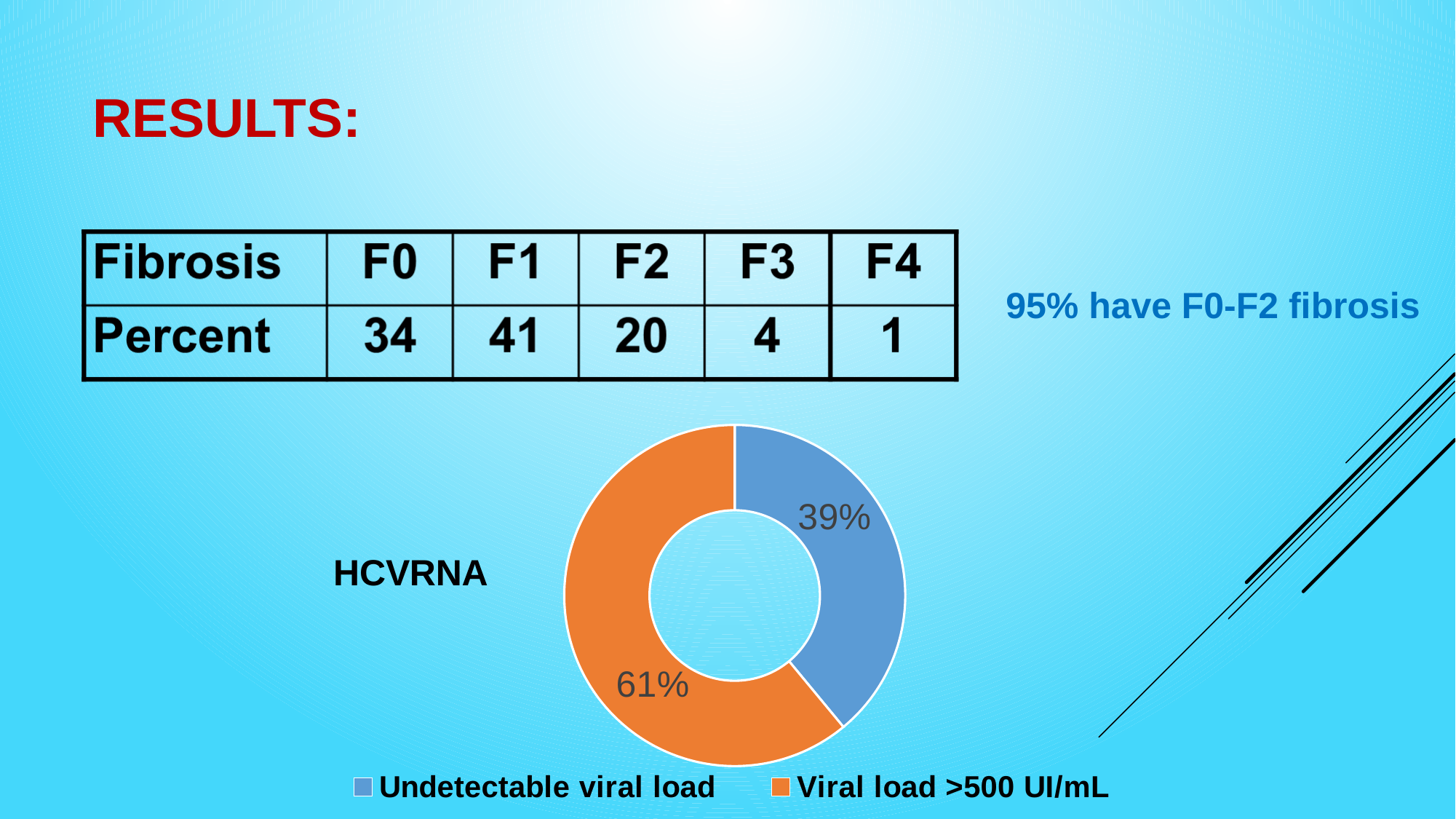
What kind of chart is the HCVRNA chart? Doughnut chart What colour represents Undetectable viral load in the HCVRNA chart? Blue In the HCVRNA chart, what is the difference in percentage points between Viral load >500 UI/mL and Undetectable viral load? 22 What is the title of the chart on the slide? HCVRNA Is the share for Undetectable viral load in the HCVRNA chart greater or less than 50%? less In the HCVRNA chart, which is larger: Undetectable viral load or Viral load >500 UI/mL? Viral load >500 UI/mL What share of the HCVRNA doughnut chart is Undetectable viral load? 39% Which category is the smallest in the HCVRNA chart? Undetectable viral load What share of the HCVRNA doughnut chart is Viral load >500 UI/mL? 61% Which category is the largest in the HCVRNA chart? Viral load >500 UI/mL How many entries does the legend of the HCVRNA chart list? 2 How many categories does the HCVRNA chart show? 2